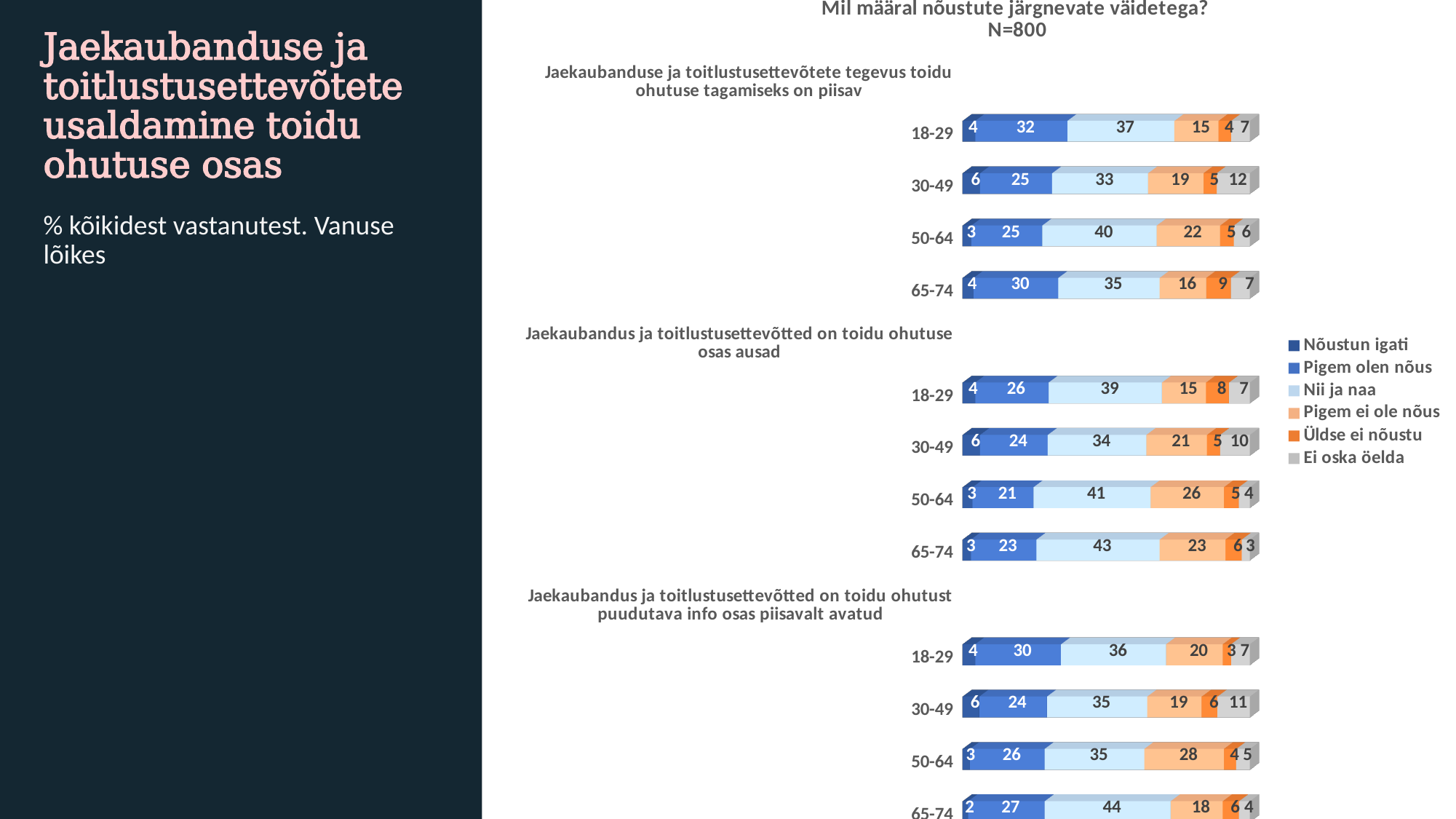
What kind of chart is shown on the slide? Stacked bar chart In the statement 'Jaekaubanduse ja toitlustusettevõtete tegevus toidu ohutuse tagamiseks on piisav', which age group has the highest 'Pigem olen nõus' value? 18-29 How many age groups are shown for each statement? 4 What is the sample size (N) stated in the chart title? N=800 In the statement 'Jaekaubanduse ja toitlustusettevõtete tegevus toidu ohutuse tagamiseks on piisav', which is larger: the 'Üldse ei nõustu' value for 65-74 or for 18-29? 65-74 In the statement 'Jaekaubanduse ja toitlustusettevõtete tegevus toidu ohutuse tagamiseks on piisav', what is the 'Nii ja naa' value for the 50-64 age group? 40 In the statement 'Jaekaubandus ja toitlustusettevõtted on toidu ohutust puudutava info osas piisavalt avatud', what is the 'Ei oska öelda' value for the 30-49 age group? 11 How many series does the legend list? 6 In the statement 'Jaekaubandus ja toitlustusettevõtted on toidu ohutust puudutava info osas piisavalt avatud', which age group has the lowest 'Nõustun igati' value? 65-74 In the statement 'Jaekaubandus ja toitlustusettevõtted on toidu ohutuse osas ausad', what is the 'Pigem ei ole nõus' value for the 50-64 age group? 26 In the statement 'Jaekaubandus ja toitlustusettevõtted on toidu ohutuse osas ausad', what is the difference between the 'Nii ja naa' values for 65-74 and 18-29? 4 In the statement 'Jaekaubandus ja toitlustusettevõtted on toidu ohutuse osas ausad', what is the total of the 'Nõustun igati' and 'Pigem olen nõus' values for the 30-49 age group? 30